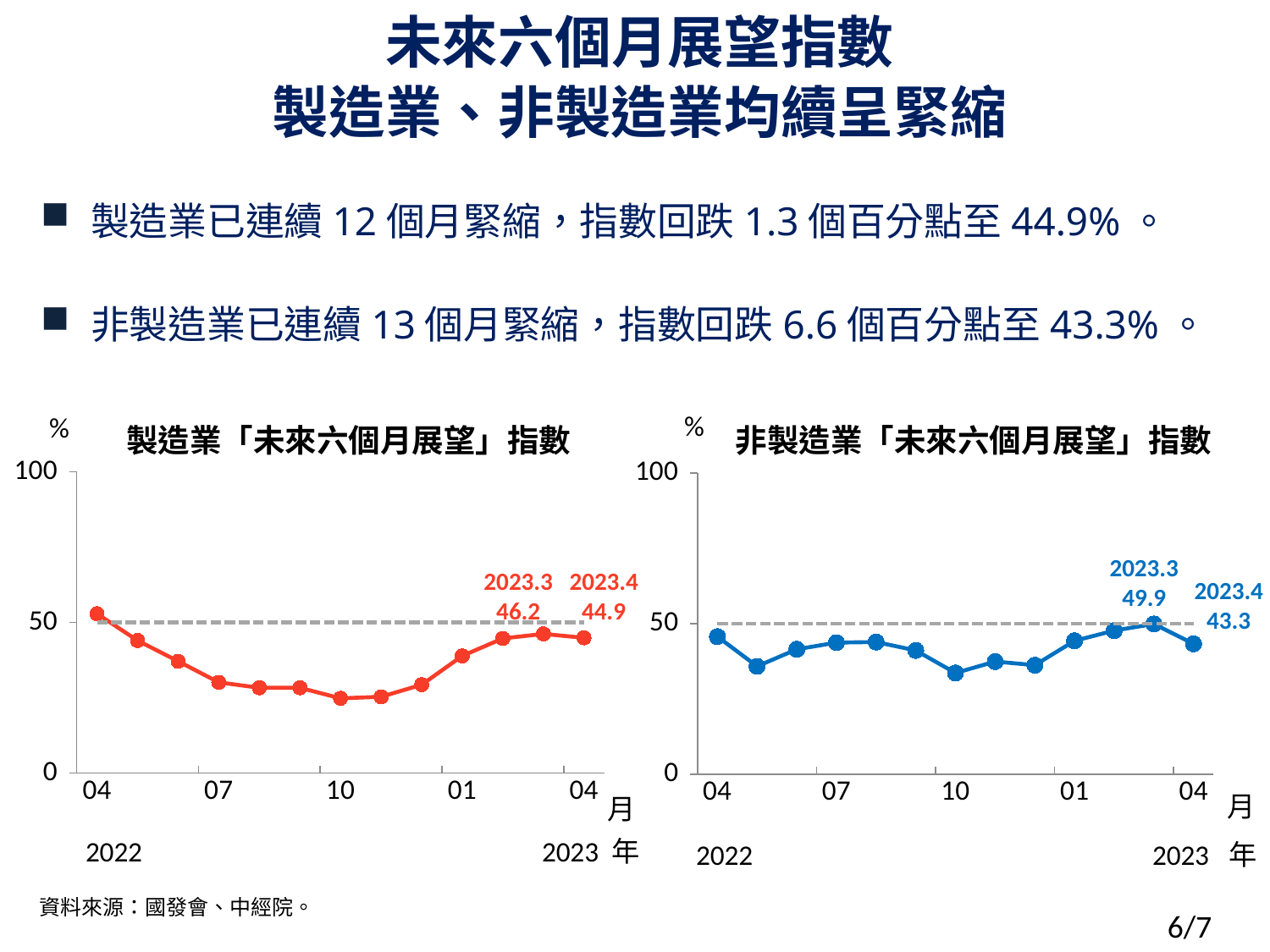
In the 非製造業「未來六個月展望」指數 chart, what is the difference between the 2023.3 and 2023.4 values? 6.6 What kind of chart is the 製造業「未來六個月展望」指數 chart? Line chart What colour is the line in the 非製造業「未來六個月展望」指數 chart? Blue In the 製造業「未來六個月展望」指數 chart, is the value for 2022 month 04 greater or less than 50? greater In the 非製造業「未來六個月展望」指數 chart, what is the value for 2023.3? 49.9 Which is larger for 2023.3: the 製造業 index or the 非製造業 index? 非製造業 index In the 製造業「未來六個月展望」指數 chart, what is the value for 2023.3? 46.2 In the 製造業「未來六個月展望」指數 chart, is the value for 2022 month 10 greater or less than 50? less How many data points are plotted in the 非製造業「未來六個月展望」指數 chart? 13 In the 製造業「未來六個月展望」指數 chart, what is the value for 2023.4? 44.9 In the 製造業「未來六個月展望」指數 chart, by how much did the value fall from 2023.3 to 2023.4? 1.3 In the 非製造業「未來六個月展望」指數 chart, what is the value for 2023.4? 43.3